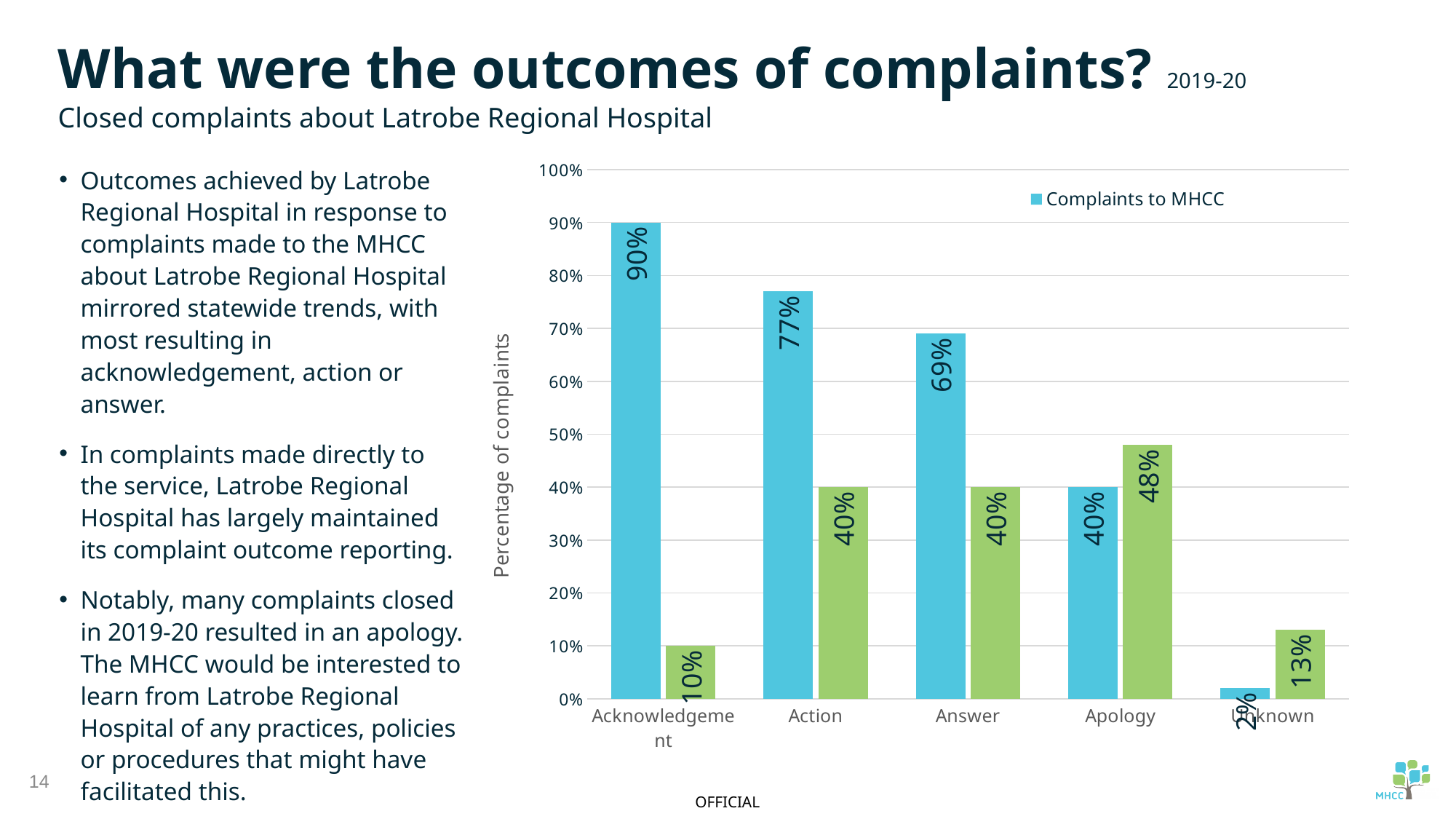
What kind of chart is shown on the slide? bar chart What is the difference between the Complaints to MHCC values for Acknowledgement and Answer? 21% What is the Complaints to MHCC value for Action? 77% Which category has the highest Complaints to MHCC value? Acknowledgement What is the Complaints to MHCC value for Unknown? 2% Which category has the lowest Complaints to MHCC value? Unknown Do the Complaints to MHCC values rise or fall from Acknowledgement to Unknown along the x axis? fall How many series does the legend list? 1 What is the Complaints to MHCC value for Acknowledgement? 90% How many categories are shown on the x axis? 5 For Apology, which is larger: the Complaints to MHCC bar or the green bar? the green bar What value does the green bar show for Apology? 48%